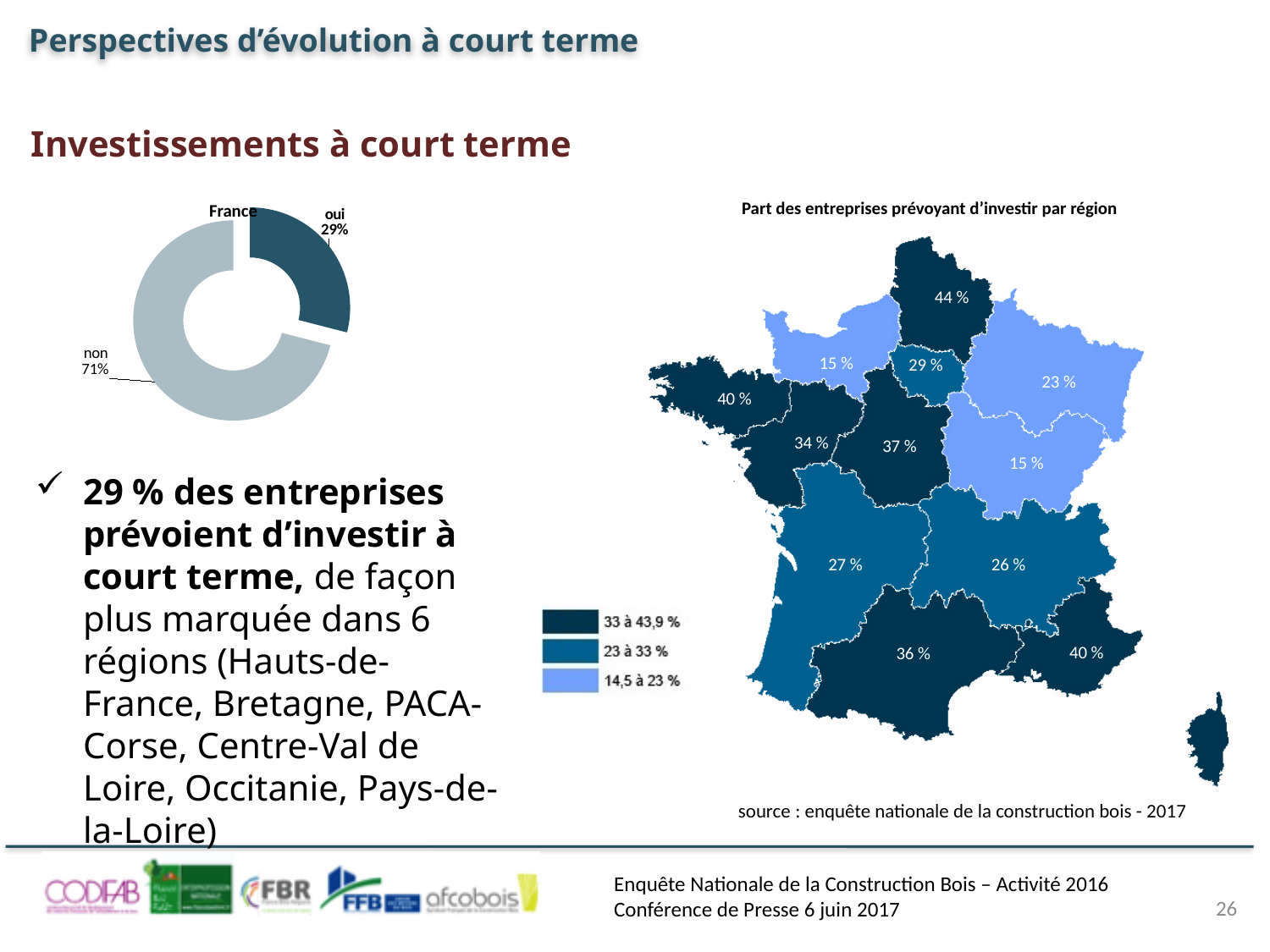
How many categories does the donut chart titled "France" show? 2 In the donut chart titled "France", which category is the smallest? oui What is the title of the map chart on the right of the slide? Part des entreprises prévoyant d'investir par région In the donut chart titled "France", is the "oui" share larger or smaller than the "non" share? smaller On the map chart, what is the lowest regional percentage shown? 15 % In the donut chart titled "France", what percentage of companies answered "non"? 71% What kind of chart is the chart titled "France"? donut (pie) chart In the donut chart titled "France", what percentage of companies answered "oui"? 29% In the donut chart titled "France", which category is the largest? non In the donut chart titled "France", what share of the whole does the "oui" slice represent? 29% On the map chart, what is the highest regional percentage shown? 44 % In the donut chart titled "France", what is the difference between the "non" and "oui" shares? 42%